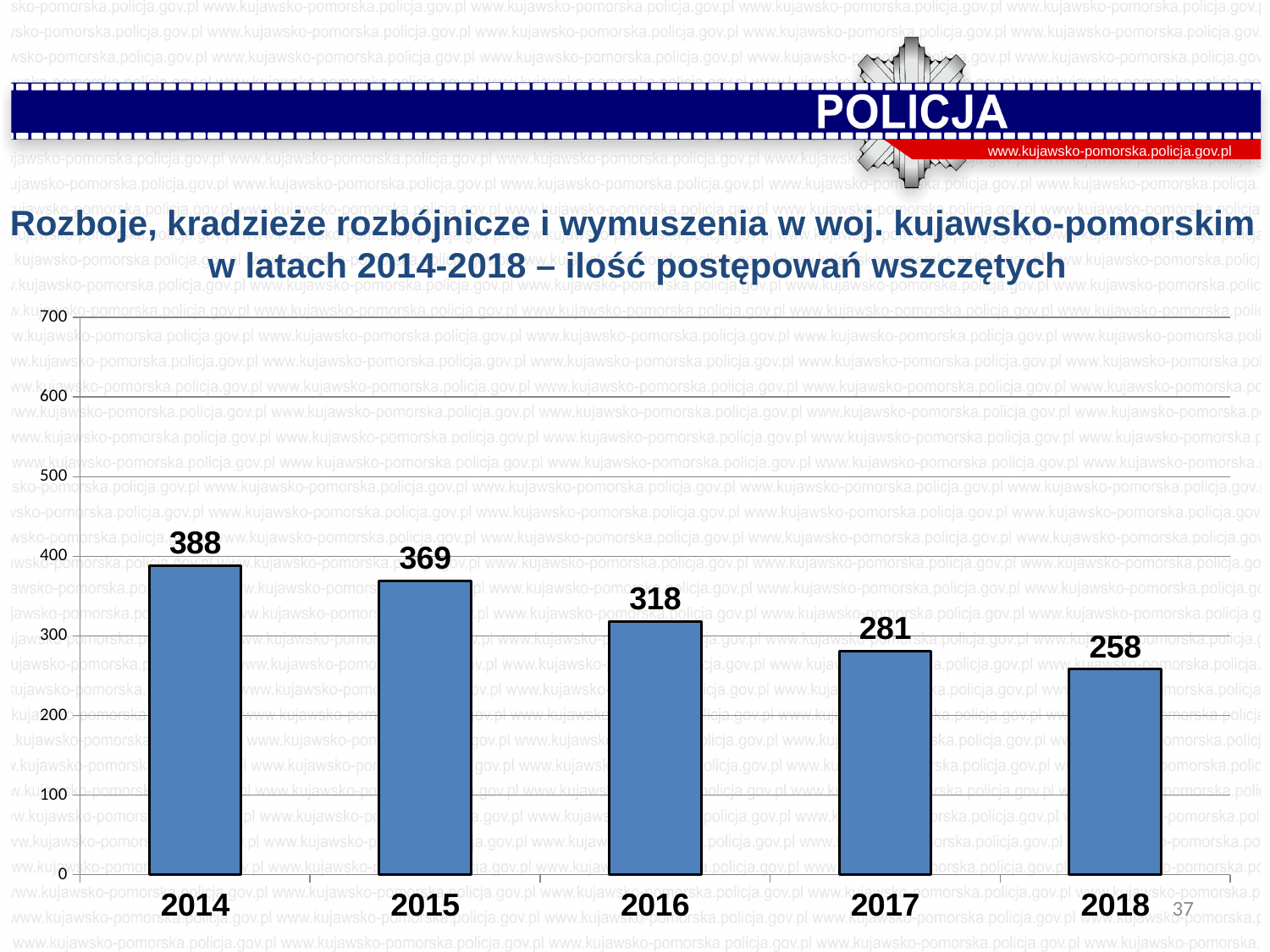
What is the value for 2014? 388 What is the value for 2018? 258 How many years are shown on the chart? 5 Which year has the lowest value? 2018 Do the values rise or fall from 2014 to 2018? fall Is the value for 2017 greater or less than 300? less Which year has the highest value? 2014 What is the difference between the values for 2015 and 2016? 51 What is the difference between the values for 2014 and 2018? 130 Which is larger, the value for 2015 or the value for 2017? 2015 What is the value for 2016? 318 What kind of chart is shown? bar chart